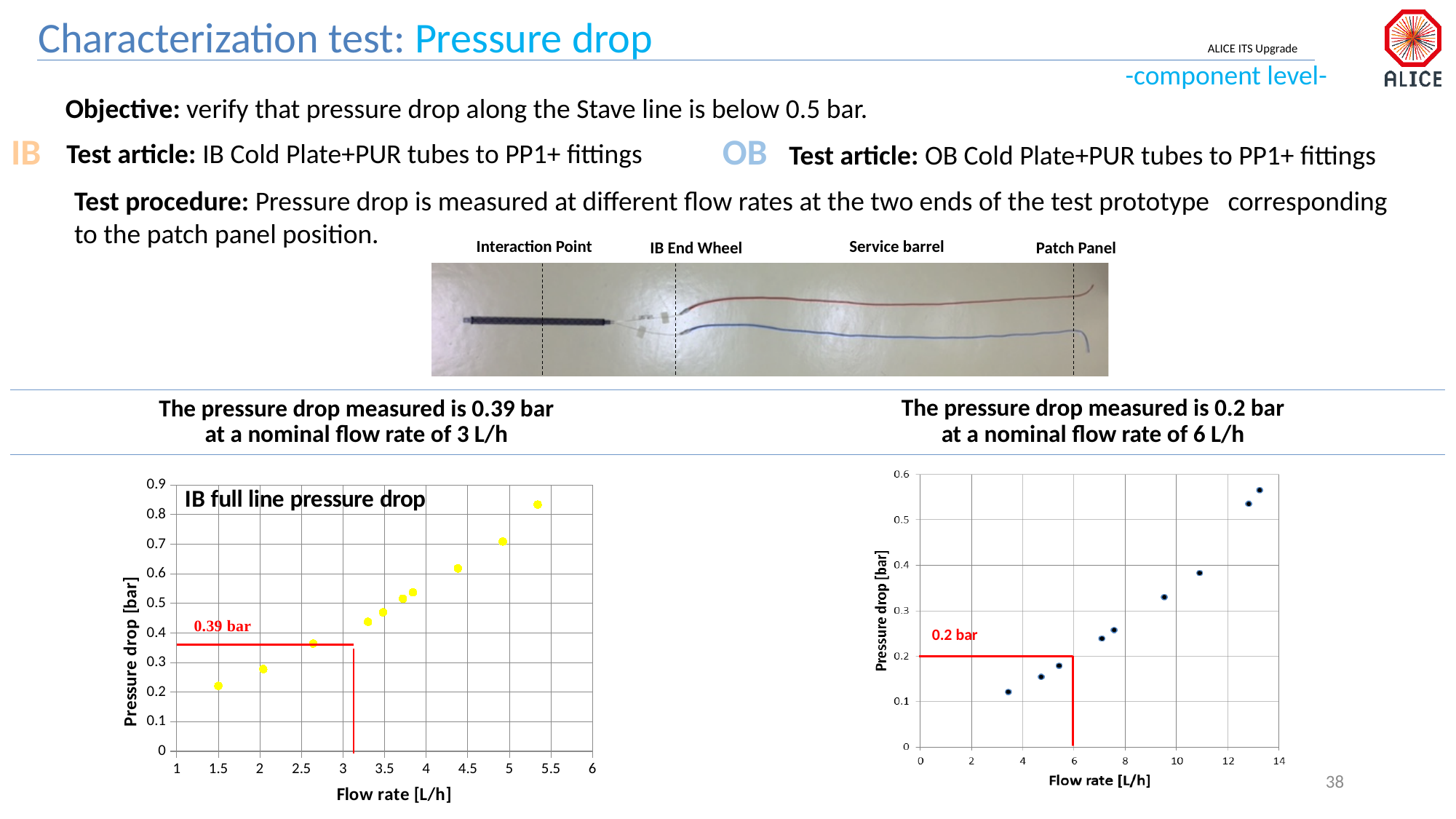
In the left chart 'IB full line pressure drop', is the pressure drop at the lowest flow rate (about 1.5 L/h) greater or less than 0.3 bar? less In the left chart 'IB full line pressure drop', is the pressure drop at the highest flow rate (about 5.4 L/h) greater or less than 0.7 bar? greater In the right chart, what is the label of the x axis? Flow rate [L/h] What kind of chart is the left chart titled 'IB full line pressure drop'? scatter chart In the left chart 'IB full line pressure drop', which point has the highest pressure drop: the one at about 5 L/h or the one at about 5.4 L/h? the one at about 5.4 L/h In the right chart, is the pressure drop at the highest flow rate (about 13 L/h) greater or less than 0.5 bar? greater In the left chart 'IB full line pressure drop', what is the label of the y axis? Pressure drop [bar] What value is written in red next to the horizontal red line in the right chart? 0.2 bar In the left chart 'IB full line pressure drop', does the pressure drop rise or fall as the flow rate increases? rise In the right chart, is the pressure drop at about 11 L/h larger or smaller than at about 9.6 L/h? larger In the right chart, does the pressure drop rise or fall as the flow rate increases? rise